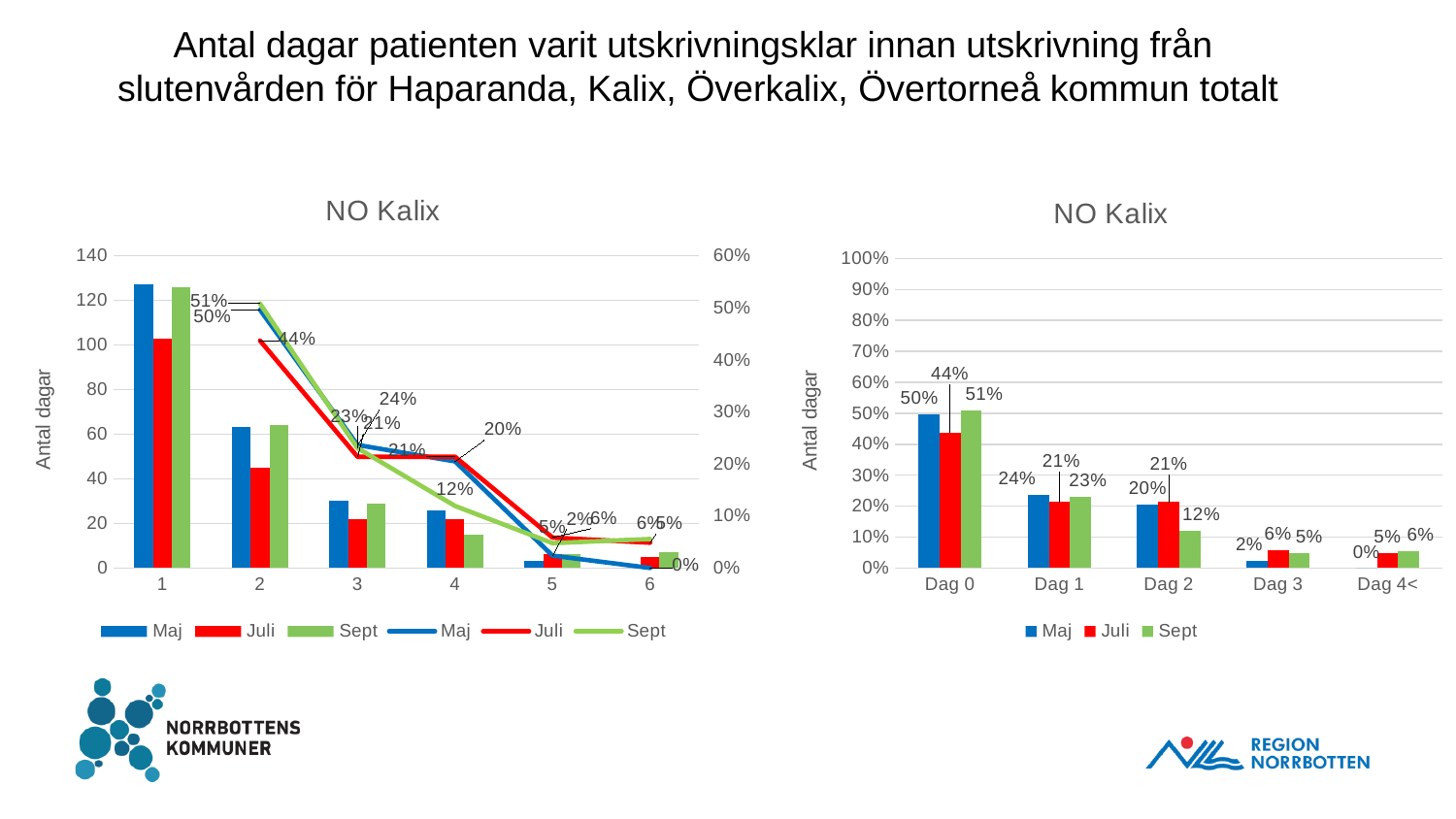
In the right-hand chart, what is the difference between the Maj and Juli values at Dag 0? 6% In the left-hand chart, is the Maj bar for category 1 greater or less than 120? greater In the right-hand chart, what is the value for Maj at Dag 4<? 0% In the right-hand chart, what is the value for Sept at Dag 0? 51% In the right-hand chart, which is larger at Dag 2: Maj or Sept? Maj In the right-hand chart, how many series does the legend list? 3 In the right-hand chart, which category has the highest value for Maj? Dag 0 In the right-hand chart, what is the value for Juli at Dag 2? 21% In the right-hand chart, which category has the lowest value for Sept? Dag 3 In the left-hand chart, is the Juli bar for category 2 greater or less than 60? less In the left-hand chart, do the bar values rise or fall from category 1 to category 6? fall In the right-hand chart, how many categories are shown on the x axis? 5